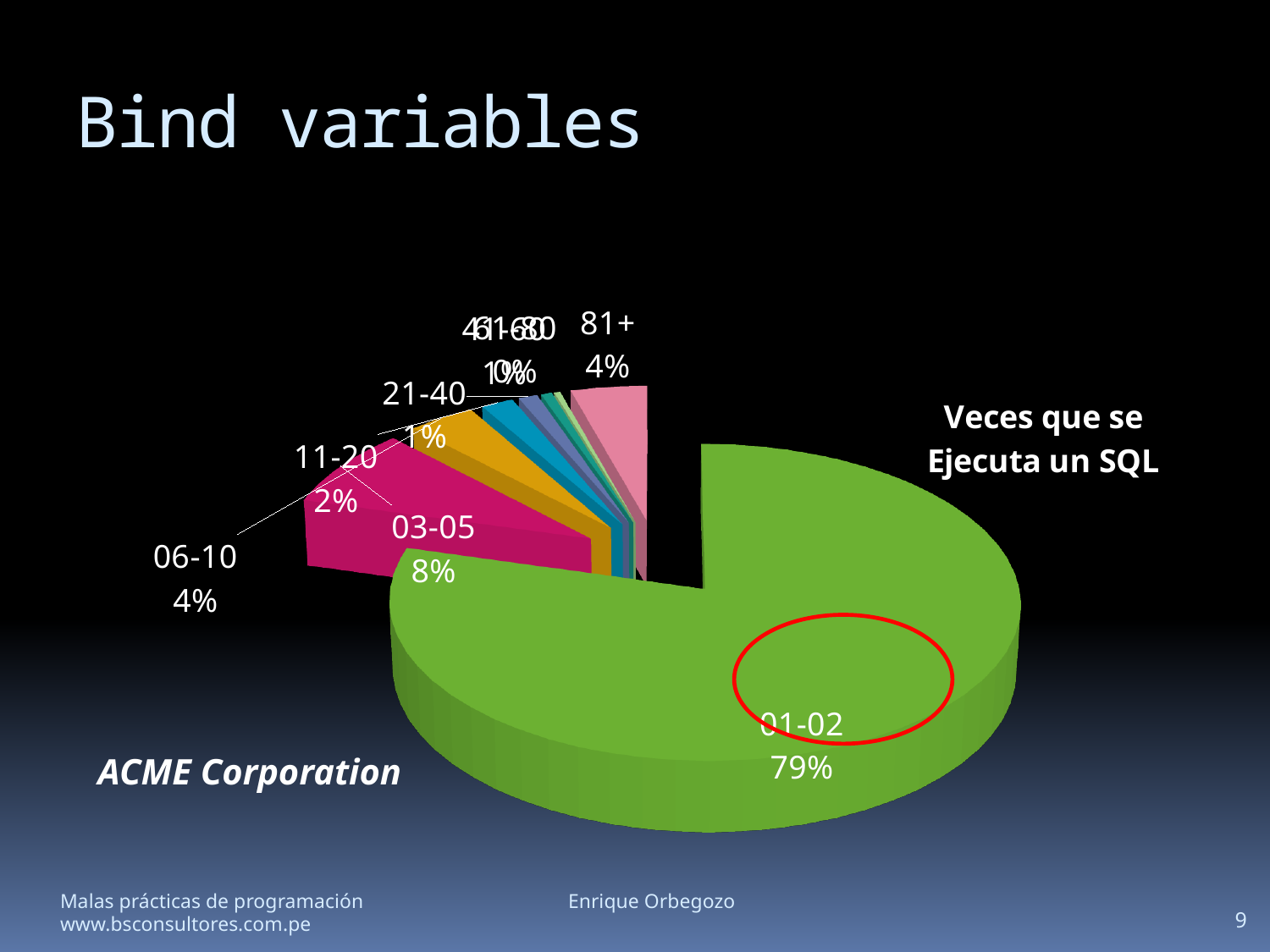
What percentage is shown for the 06-10 slice? 4% What percentage is shown for the 11-20 slice? 2% What percentage is shown for the 81+ slice? 4% What is the difference in percentage points between the 01-02 slice and the 03-05 slice? 71 percentage points What is the title of the pie chart? Veces que se Ejecuta un SQL What percentage is shown for the 21-40 slice? 1% What kind of chart is shown on the slide? pie chart What percentage of the pie does the 01-02 slice represent? 79% Which slice is larger, 11-20 or 81+? 81+ Which slice is larger, 03-05 or 06-10? 03-05 Which category has the largest slice of the pie? 01-02 What percentage is shown for the 03-05 slice? 8%